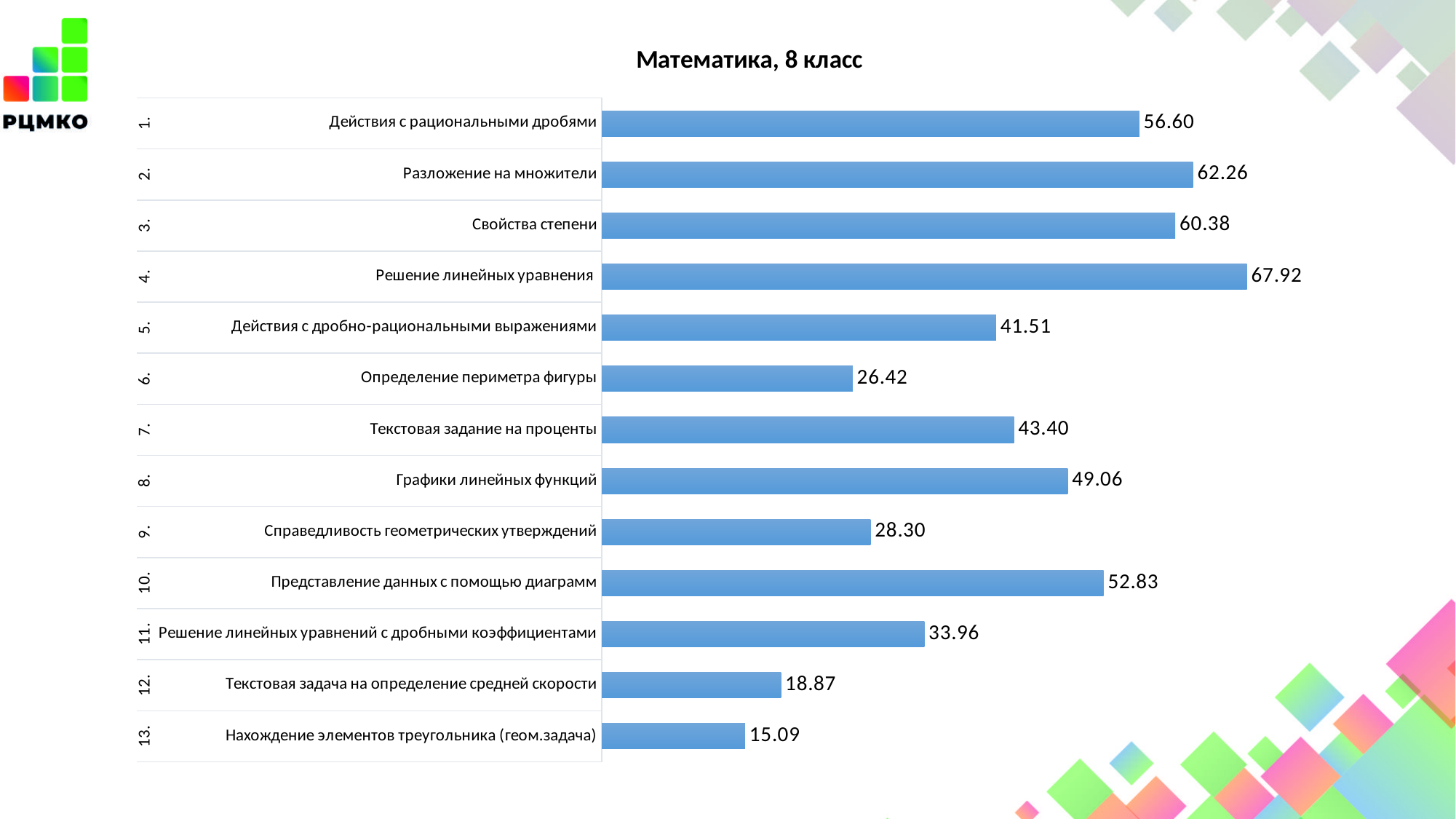
Which category has the lowest value? Нахождение элементов треугольника (геом.задача) What kind of chart is shown on the slide? Bar chart What is the value for "Решение линейных уравнений с дробными коэффициентами"? 33.96 Which category has the highest value? Решение линейных уравнения What is the difference between the values for "Разложение на множители" and "Свойства степени"? 1.88 What is the value for "Решение линейных уравнения"? 67.92 How many categories are shown in the chart? 13 Which is larger: the value for "Действия с рациональными дробями" or the value for "Представление данных с помощью диаграмм"? Действия с рациональными дробями What is the value for "Графики линейных функций"? 49.06 What is the value for "Определение периметра фигуры"? 26.42 What is the title of the chart? Математика, 8 класс What is the difference between the values for "Текстовая задача на определение средней скорости" and "Нахождение элементов треугольника (геом.задача)"? 3.78